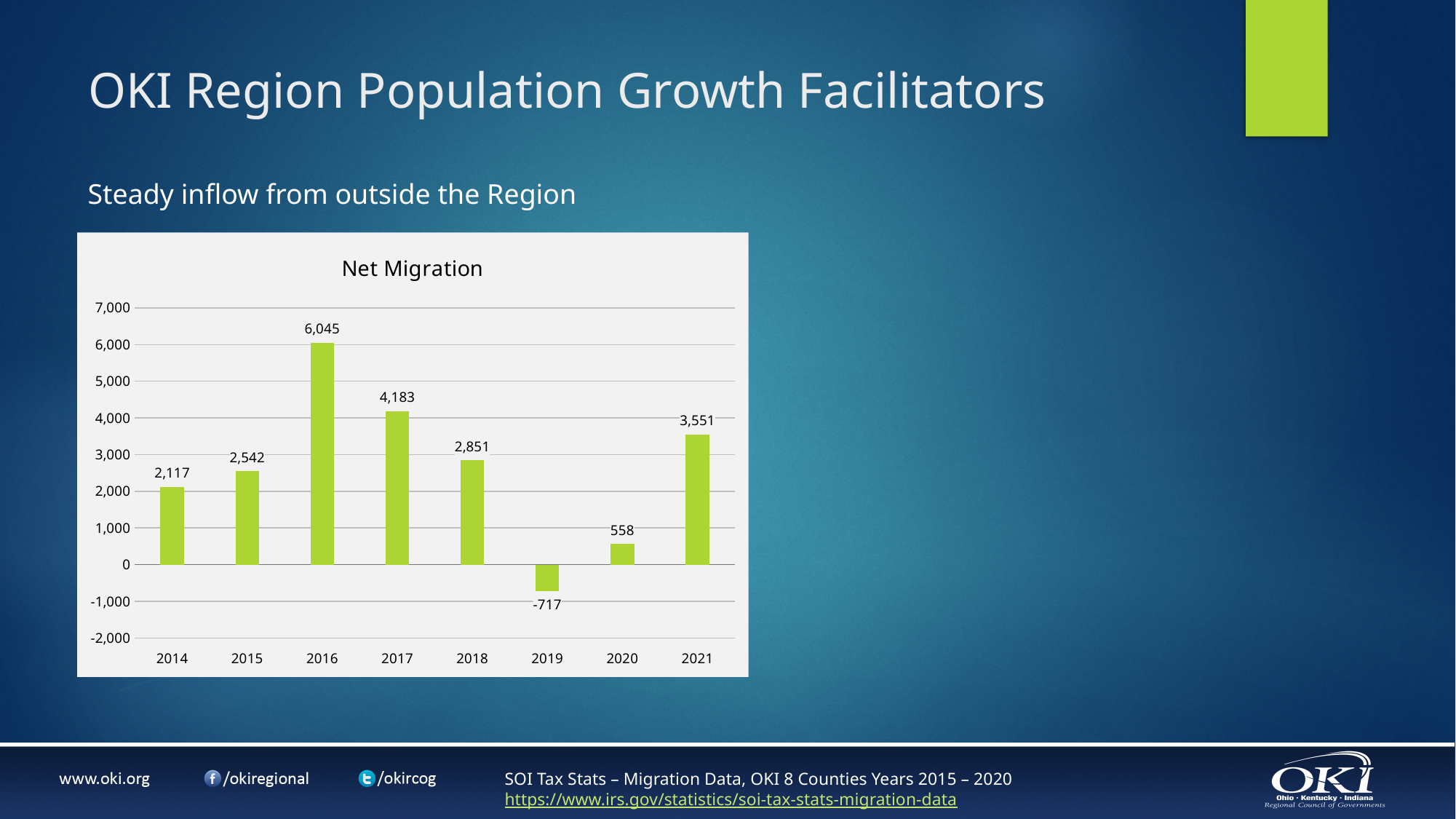
What is the net migration value for 2016? 6,045 What is the net migration value for 2021? 3,551 What is the net migration value for 2019? -717 How many years are shown on the x axis of the chart? 8 What is the difference between the net migration in 2016 and 2017? 1,862 Is the net migration value for 2020 greater or less than 1,000? less Which year has the highest net migration? 2016 What kind of chart is shown on the slide? bar chart Does net migration rise or fall from 2014 to 2016? rise Which year has a larger net migration, 2015 or 2018? 2018 Which year has the lowest net migration? 2019 What is the title of the chart? Net Migration